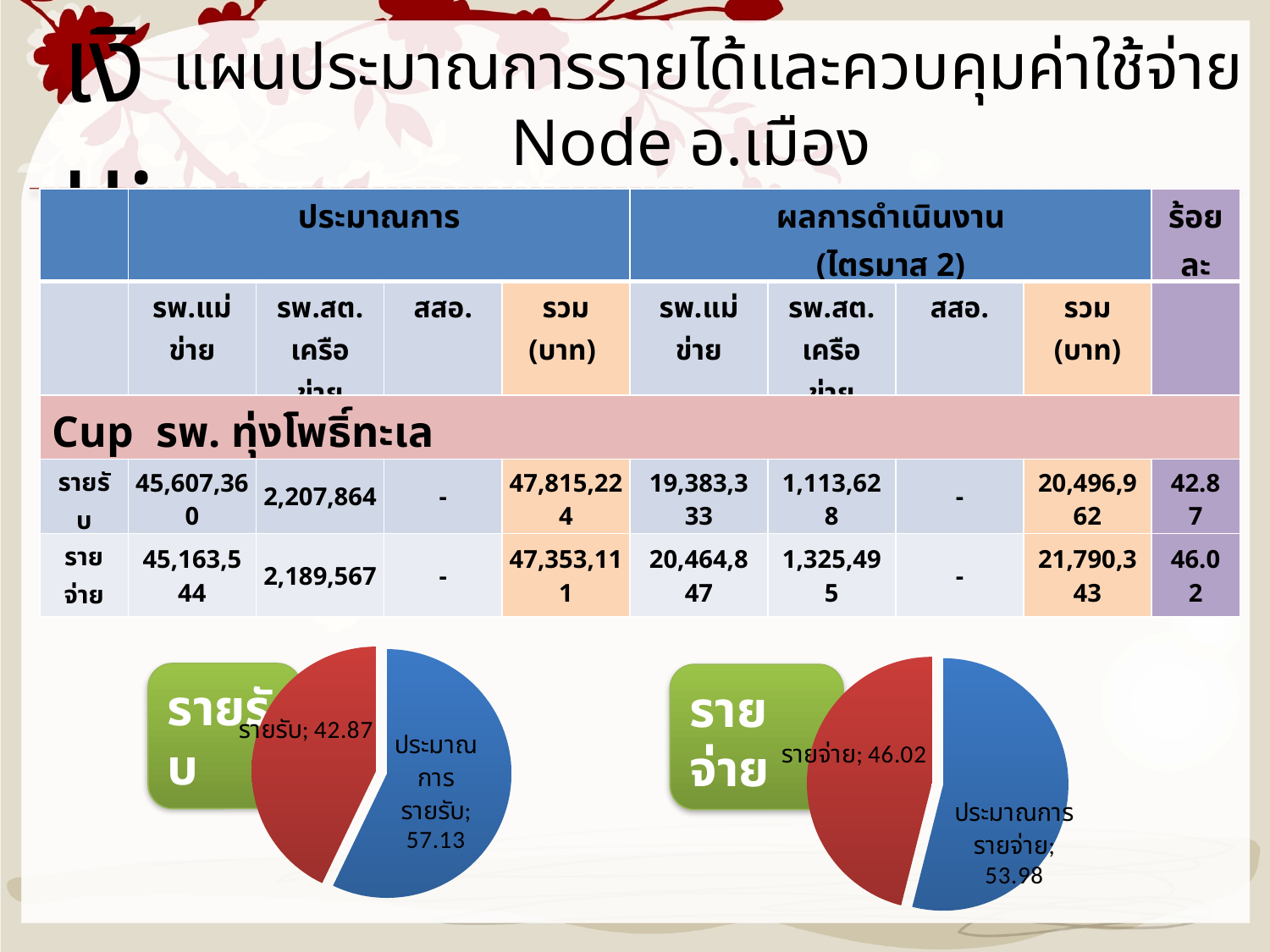
In the left pie chart (รายรับ), what is the value of the slice labelled รายรับ? 42.87 In the right pie chart (รายจ่าย), which slice is the smallest? รายจ่าย How many slices does the left pie chart (รายรับ) have? 2 In the right pie chart (รายจ่าย), which slice is larger: รายจ่าย or ประมาณการรายจ่าย? ประมาณการรายจ่าย In the right pie chart (รายจ่าย), what is the value of the slice labelled รายจ่าย? 46.02 In the left pie chart (รายรับ), what is the value of the slice labelled ประมาณการรายรับ? 57.13 In the right pie chart (รายจ่าย), what is the difference between the ประมาณการรายจ่าย slice and the รายจ่าย slice? 7.96 What type of chart is the right chart (รายจ่าย)? Pie chart In the left pie chart (รายรับ), what colour is the slice labelled รายรับ? Red In the left pie chart (รายรับ), what is the difference between the ประมาณการรายรับ slice and the รายรับ slice? 14.26 In the right pie chart (รายจ่าย), what is the value of the slice labelled ประมาณการรายจ่าย? 53.98 In the left pie chart (รายรับ), which slice is the largest? ประมาณการรายรับ